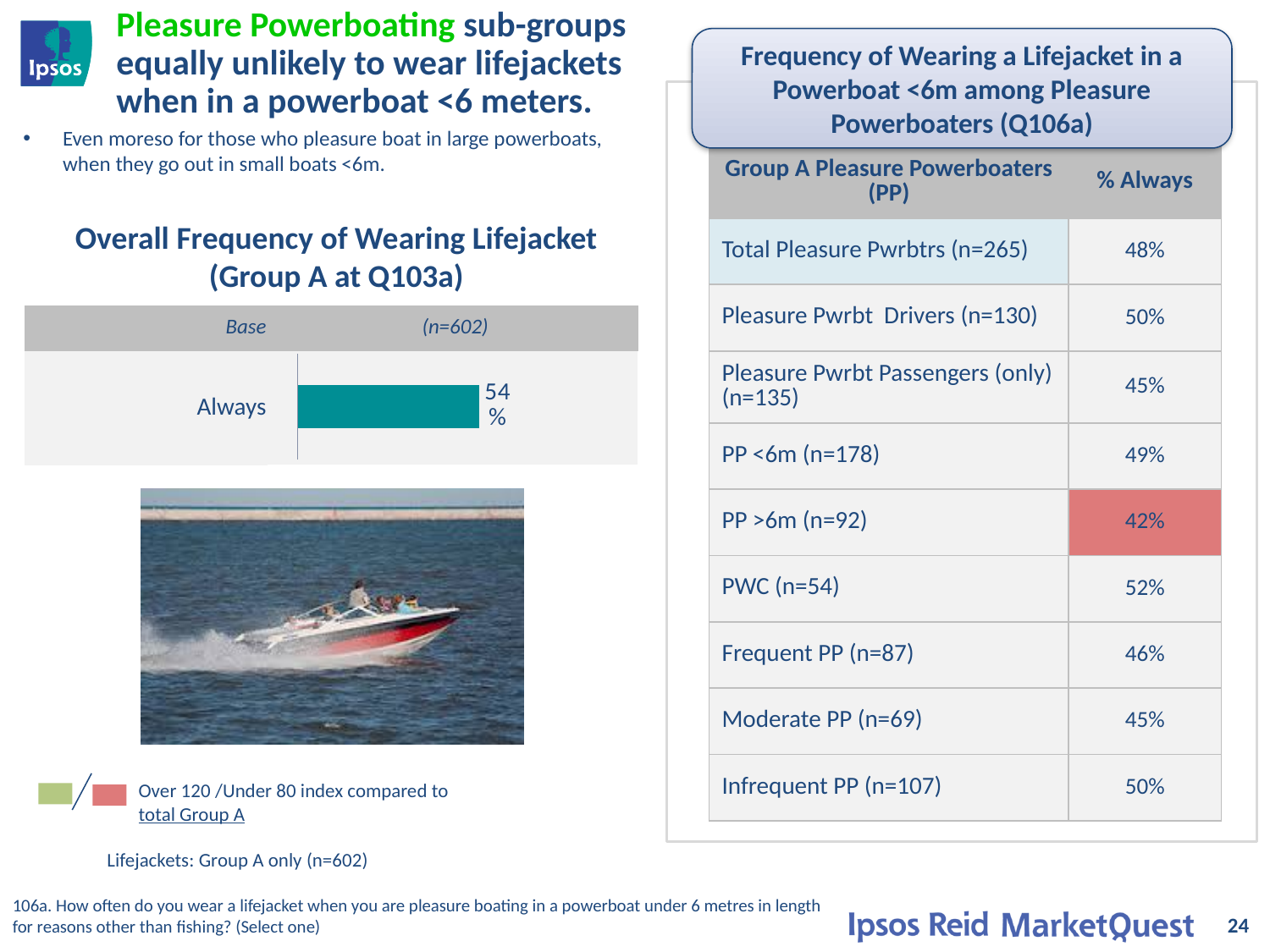
What is the label of the single bar in the 'Overall Frequency of Wearing Lifejacket (Group A at Q103a)' chart? Always In the 'Overall Frequency of Wearing Lifejacket (Group A at Q103a)' chart, what is the value for Always? 54% What base size (n) is shown above the 'Overall Frequency of Wearing Lifejacket' bar chart? n=602 How many categories are plotted in the 'Overall Frequency of Wearing Lifejacket (Group A at Q103a)' chart? 1 What is the title of the bar chart on the left side of the slide? Overall Frequency of Wearing Lifejacket (Group A at Q103a) What kind of chart is the 'Overall Frequency of Wearing Lifejacket (Group A at Q103a)' chart? bar chart